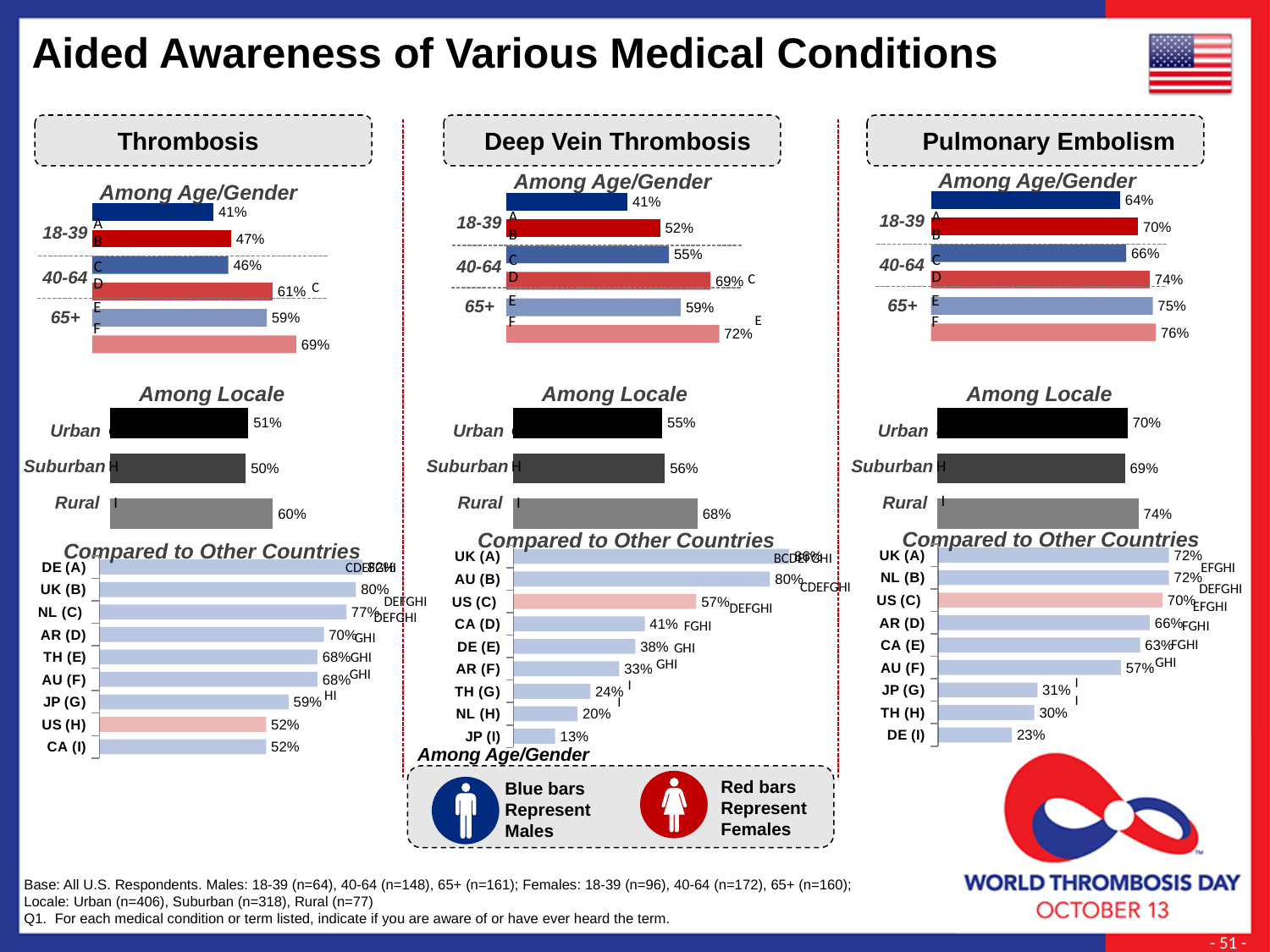
In the Deep Vein Thrombosis 'Compared to Other Countries' chart, which country has the lowest value? JP (I) In the Thrombosis 'Compared to Other Countries' chart, which is larger, the value for UK (B) or the value for AR (D)? UK (B) In the Pulmonary Embolism 'Among Locale' chart, which locale has the highest value? Rural In the Thrombosis 'Among Age/Gender' chart, what is the value for females aged 40-64 (bar D)? 61% According to the legend on the slide, what do the red bars in the 'Among Age/Gender' charts represent? Females What kind of chart is the Thrombosis 'Among Locale' chart? bar chart In the Pulmonary Embolism 'Compared to Other Countries' chart, how many countries are listed? 9 In the Deep Vein Thrombosis 'Compared to Other Countries' chart, what is the value for JP (I)? 13% In the Deep Vein Thrombosis 'Among Age/Gender' chart, do the male values rise or fall from the 18-39 group to the 65+ group? rise In the Thrombosis 'Among Locale' chart, what is the value for Rural? 60% In the Pulmonary Embolism 'Among Age/Gender' chart, what is the difference between females 65+ (F) and males 65+ (E)? 1% In the Deep Vein Thrombosis 'Among Locale' chart, what is the difference between Rural and Urban? 13%